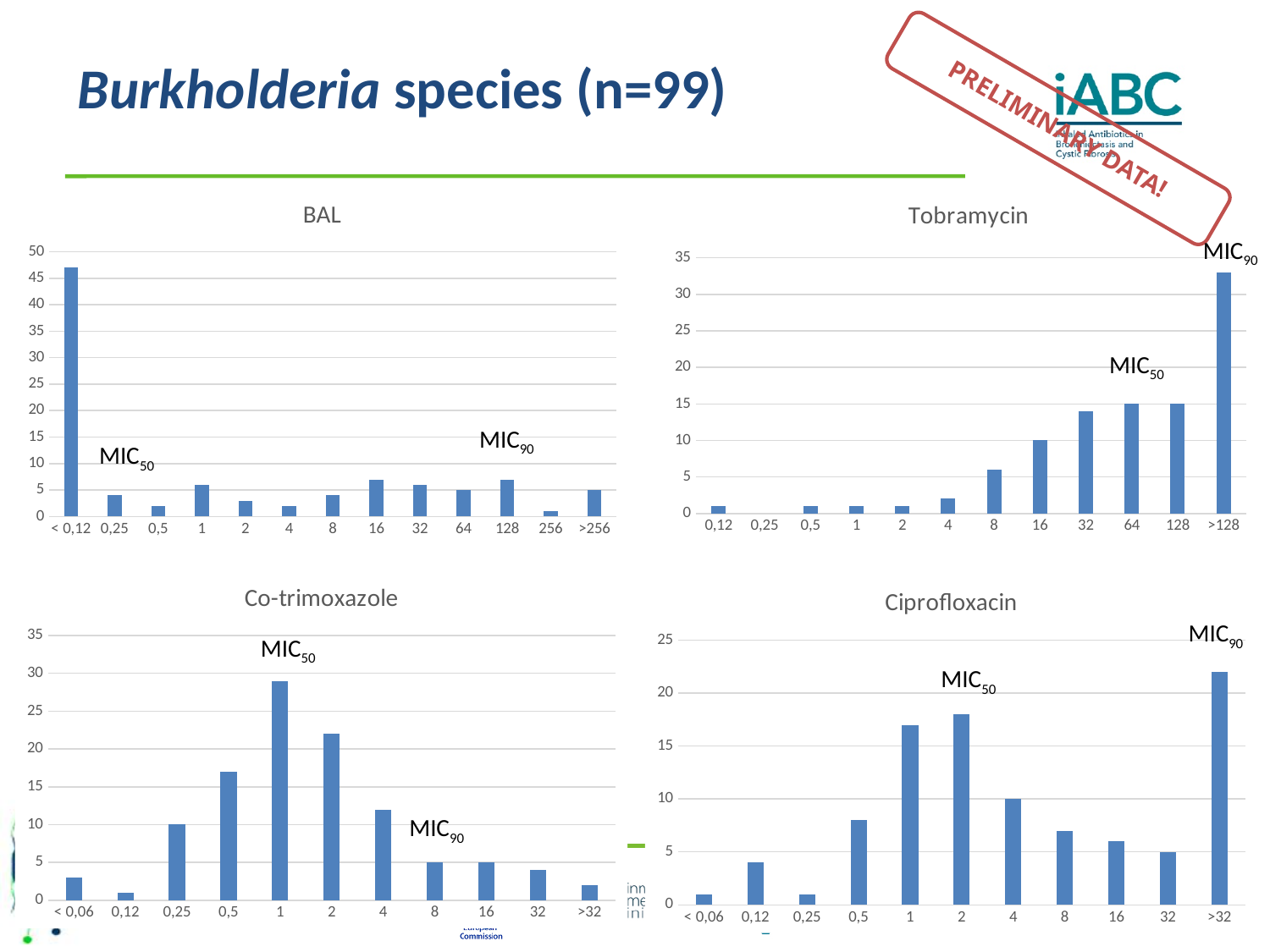
In the Ciprofloxacin chart, which category has the highest bar? >32 In the Tobramycin chart, which category has the highest bar? >128 In the Co-trimoxazole chart, which category has the highest bar? 1 How many categories are shown on the x axis of the Co-trimoxazole chart? 11 In the BAL chart, is the value for < 0,12 greater or less than 45? greater In the Tobramycin chart, what is the value for 64? 15 In the Co-trimoxazole chart, is the value for 1 greater or less than 25? greater In the Co-trimoxazole chart, what is the value for 0,25? 10 In the Ciprofloxacin chart, what is the value for 4? 10 In the Tobramycin chart, what is the value for 16? 10 In the Ciprofloxacin chart, which is larger, the value for 2 or the value for 4? 2